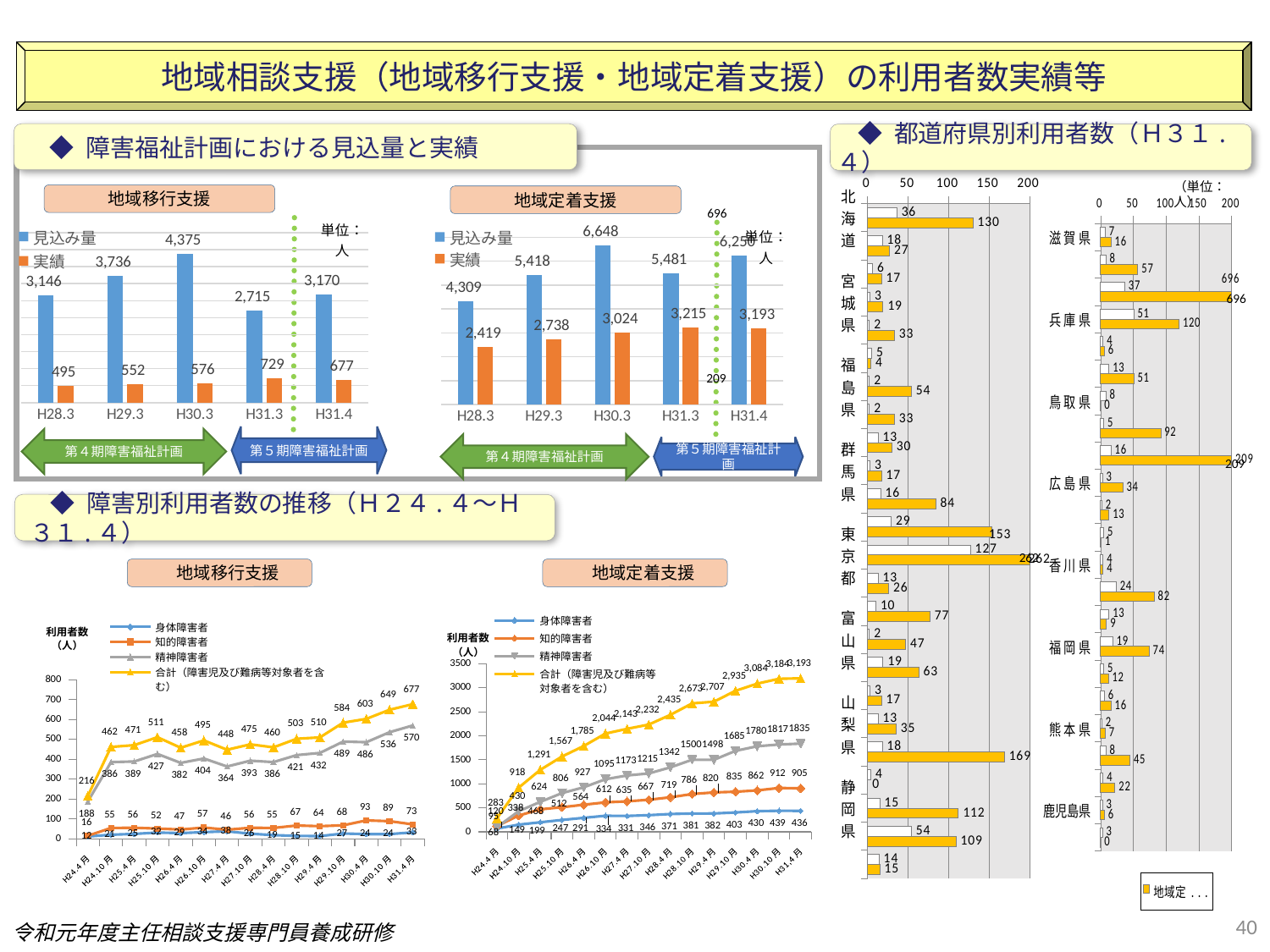
In the bottom-middle line chart (地域定着支援 障害別利用者数の推移), does the 合計 line generally rise or fall from H24.4月 to H31.4月? rise What kind of chart is the 地域定着支援 見込量と実績 chart at the top of the slide? bar chart In the bottom-middle line chart (地域定着支援 障害別利用者数の推移), what is the 精神障害者 value at H31.4月? 1835 In the bottom-left line chart (地域移行支援 障害別利用者数の推移), what is the 合計 value at H31.4月? 677 In the top-left bar chart (地域移行支援 見込量と実績), what is the difference between 見込み量 and 実績 for H30.3? 3,799 How many periods are shown on the x axis of the top 地域定着支援 bar chart (見込量と実績)? 5 In the bottom-left line chart (地域移行支援 障害別利用者数の推移), at which point is the 知的障害者 value highest? H30.4月 In the top 地域定着支援 bar chart (見込量と実績), what is the 見込み量 for H30.3? 6,648 How many series does the legend of the top-left bar chart (地域移行支援 見込量と実績) list? 2 In the top-left bar chart (地域移行支援 見込量と実績), which period has the highest 見込み量? H30.3 In the top-left bar chart (地域移行支援 見込量と実績), what is the 実績 value for H31.3? 729 In the top 地域定着支援 bar chart (見込量と実績), which is larger, the 実績 for H31.3 or for H31.4? H31.3